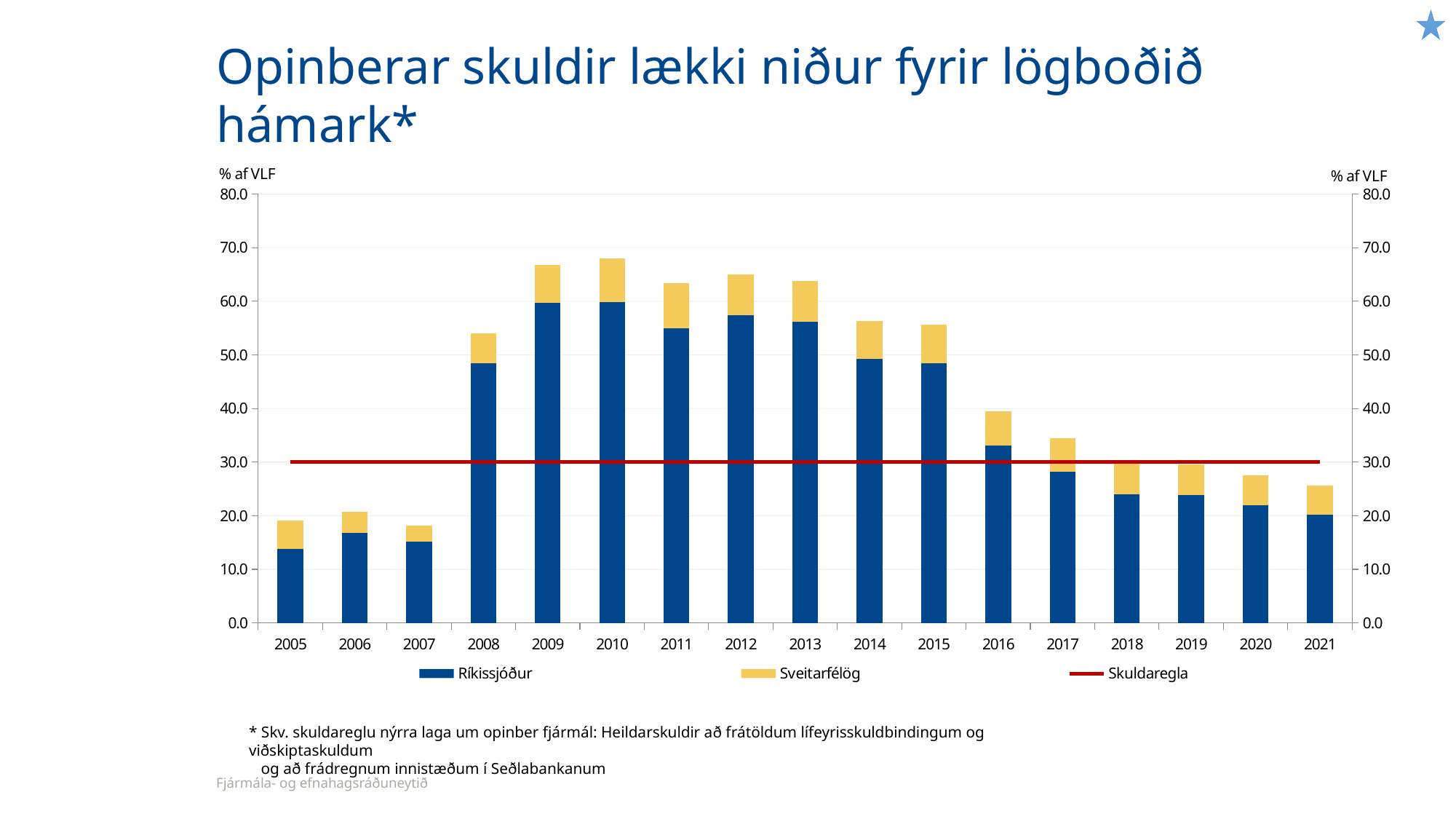
How many series does the legend list? 3 Is the total stacked value for 2010 greater or less than 60.0? greater Is the total stacked value for 2021 greater or less than 30.0? less Which year has the highest total public debt (stacked bar)? 2010 Which year has the larger total stacked bar, 2008 or 2015? 2015 Do the total stacked values rise or fall from 2010 to 2021? fall Which year has the lowest total public debt (stacked bar)? 2007 What are the three legend entries of the chart? Ríkissjóður, Sveitarfélög, Skuldaregla Is the Ríkissjóður value for 2017 greater or less than 30.0? less How many years are shown on the x axis of the chart? 17 At what level (% af VLF) is the Skuldaregla line drawn? 30.0 What kind of chart is shown on the slide? stacked bar chart with a line